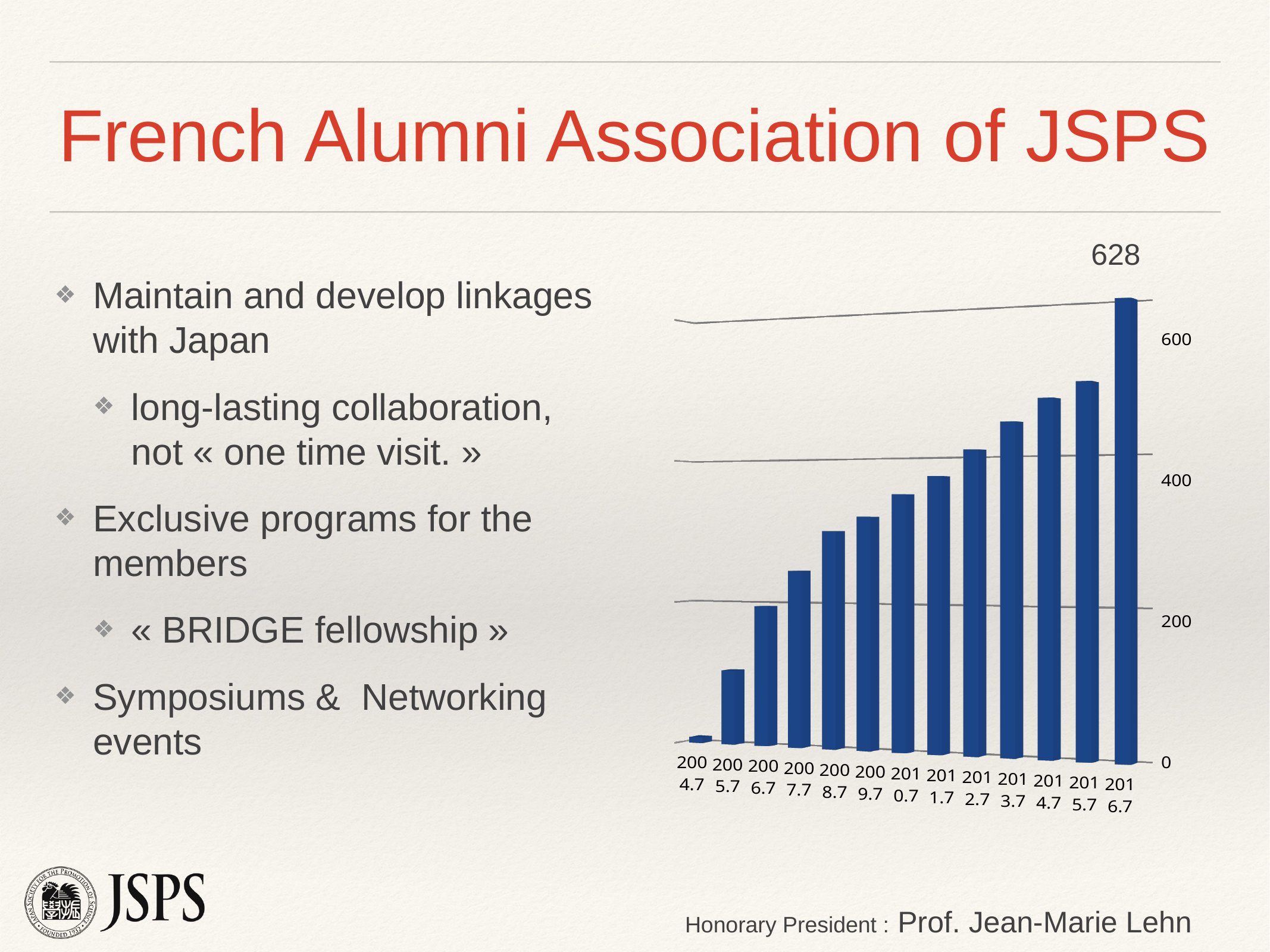
Is the value for 2005.7 greater or less than 200? less Is the value for 2008.7 greater or less than 200? greater Is the value for 2015.7 greater or less than 600? less What value is labelled on the bar for 2016.7? 628 What kind of chart is shown on the slide? bar chart Do the values rise or fall from left to right along the x axis? rise How many bars are plotted in the chart? 13 What is the highest tick value shown on the vertical axis? 600 Which category has the highest bar? 2016.7 Which category has the lowest bar? 2004.7 Which is larger, the value for 2010.7 or the value for 2005.7? 2010.7